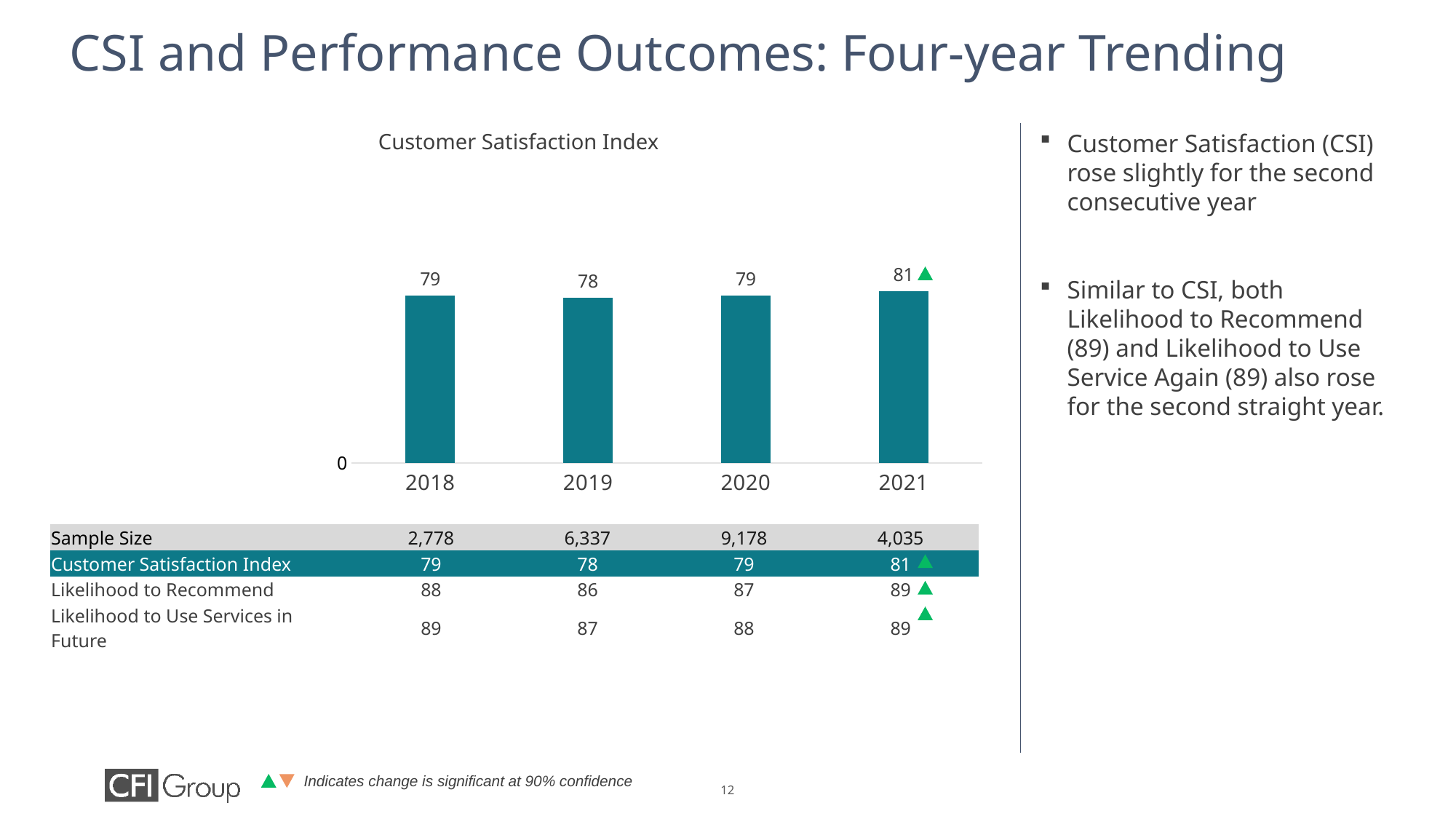
What is the Customer Satisfaction Index value for 2021? 81 Which year has the lowest Customer Satisfaction Index? 2019 Which year's bar on the Customer Satisfaction Index chart is marked with a green triangle? 2021 What is the Customer Satisfaction Index value for 2019? 78 What kind of chart is the Customer Satisfaction Index chart? bar chart How many years are shown on the Customer Satisfaction Index chart? 4 Which year has the highest Customer Satisfaction Index? 2021 What is the Customer Satisfaction Index value for 2018? 79 Did the Customer Satisfaction Index rise or fall from 2020 to 2021? rise Which year has a larger Customer Satisfaction Index, 2020 or 2021? 2021 What is the difference between the Customer Satisfaction Index in 2021 and in 2019? 3 What is the title of the chart? Customer Satisfaction Index